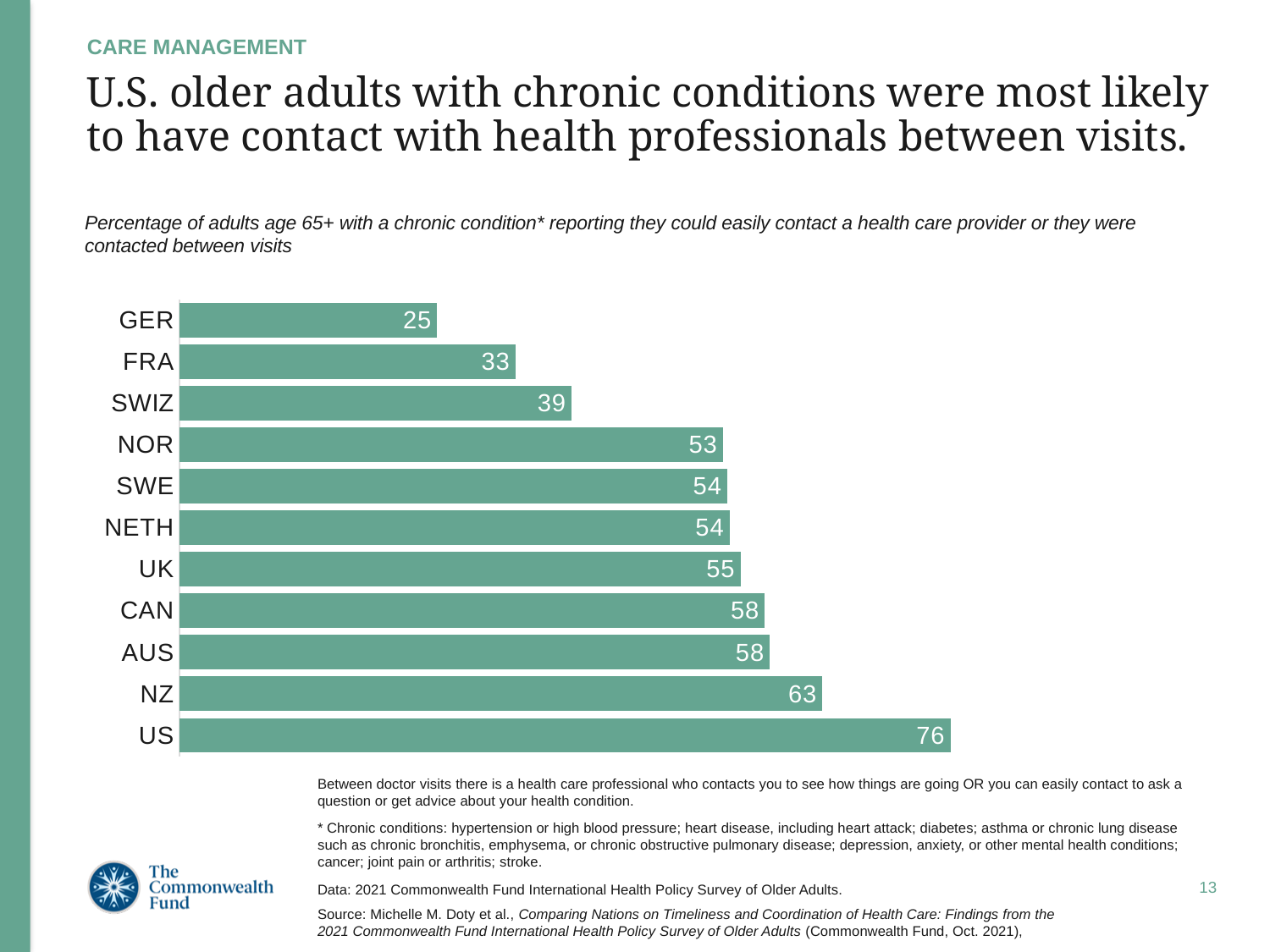
What is the difference between the values for NZ and FRA? 30 Which two countries both have a value of 58? CAN and AUS What is the value for NZ? 63 What is the value for SWIZ? 39 Which has a larger value, NOR or SWIZ? NOR Which country has the highest value? US Which country has the lowest value? GER What is the value for the US? 76 How many countries are shown in the chart? 11 What kind of chart is shown on the slide? Bar chart What is the difference between the values for the US and GER? 51 What is the value for GER? 25